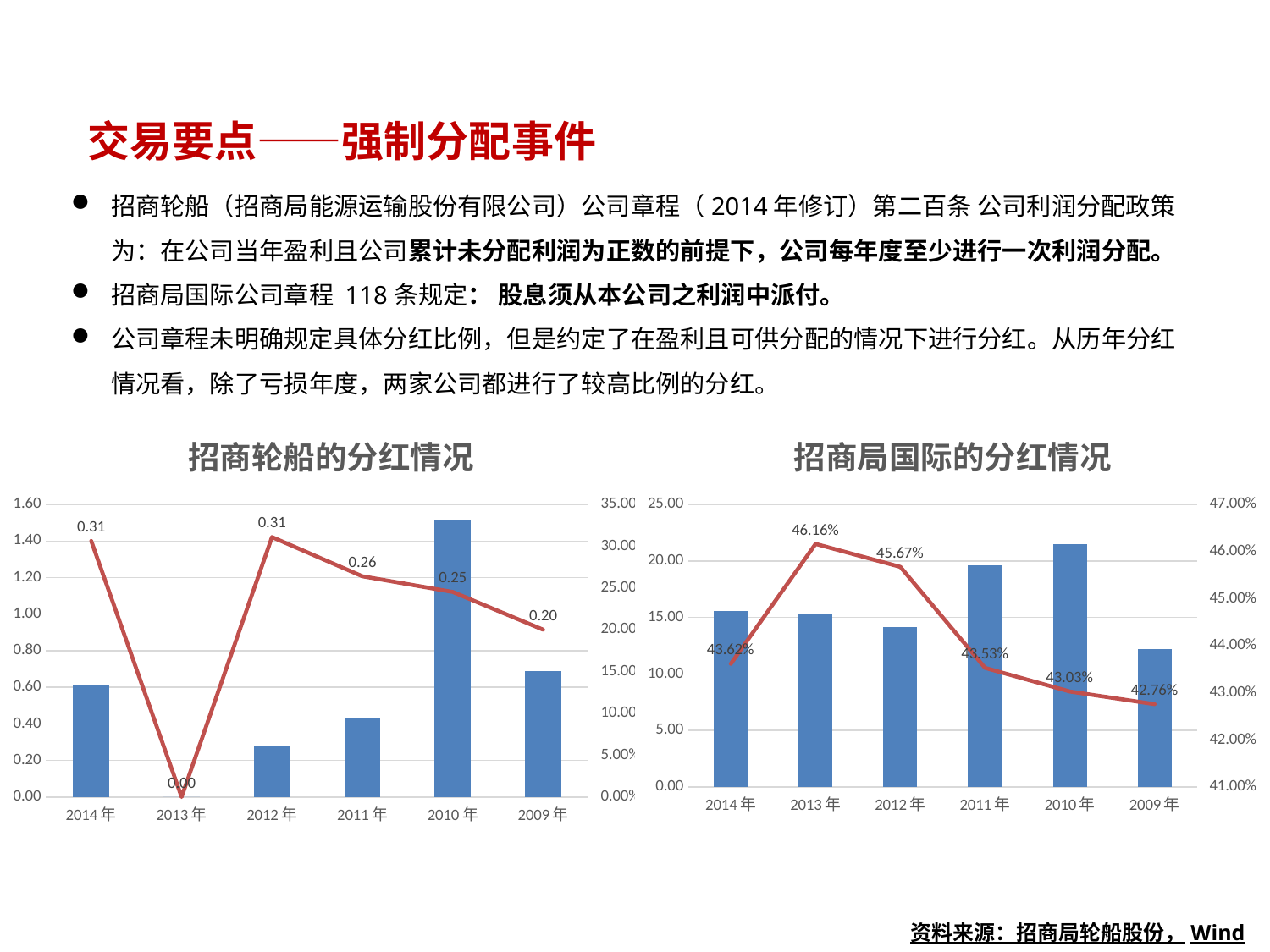
In the chart titled 招商轮船的分红情况, how many years are shown on the x axis? 6 In the chart titled 招商轮船的分红情况, is the bar for 2010年 greater or less than 1.40 on the left axis? greater In the chart titled 招商局国际的分红情况, which year has the lowest labelled line value? 2009年 In the chart titled 招商局国际的分红情况, which year has the highest labelled line value? 2013年 In the chart titled 招商轮船的分红情况, what is the labelled line value for 2013年? 0.00 In the chart titled 招商轮船的分红情况, what is the labelled line value for 2011年? 0.26 In the chart titled 招商轮船的分红情况, which year has the tallest bar? 2010年 In the chart titled 招商局国际的分红情况, which year has the tallest bar? 2010年 In the chart titled 招商局国际的分红情况, does the line value rise or fall from 2011年 to 2009年? fall In the chart titled 招商局国际的分红情况, what is the labelled line value for 2013年? 46.16% What kind of chart is the chart titled 招商轮船的分红情况? Combined bar and line chart In the chart titled 招商局国际的分红情况, what is the difference between the line values for 2013年 and 2009年? 3.40%